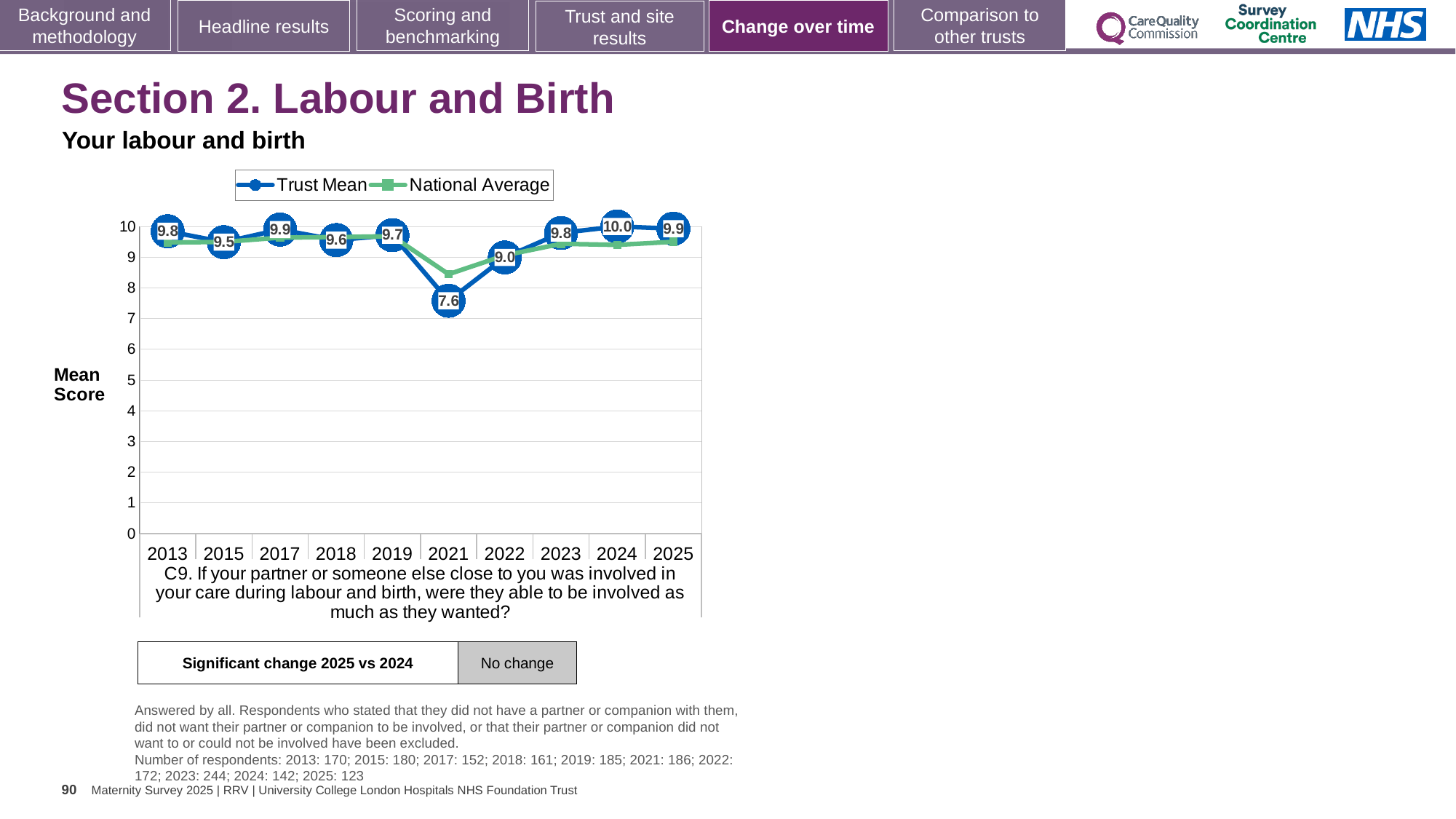
Which year has the larger Trust Mean, 2021 or 2022? 2022 How many series does the legend list? 2 What is the Trust Mean value for 2024? 10.0 What is the difference between the Trust Mean in 2024 and in 2021? 2.4 In which year is the Trust Mean lowest? 2021 Does the Trust Mean rise or fall from 2021 to 2024? Rise Is the National Average value for 2021 greater or less than 9? less In which year is the Trust Mean highest? 2024 What is the Trust Mean value for 2021? 7.6 How many years are shown on the x axis? 10 What is the Trust Mean value for 2015? 9.5 What kind of chart is shown on the slide? Line chart